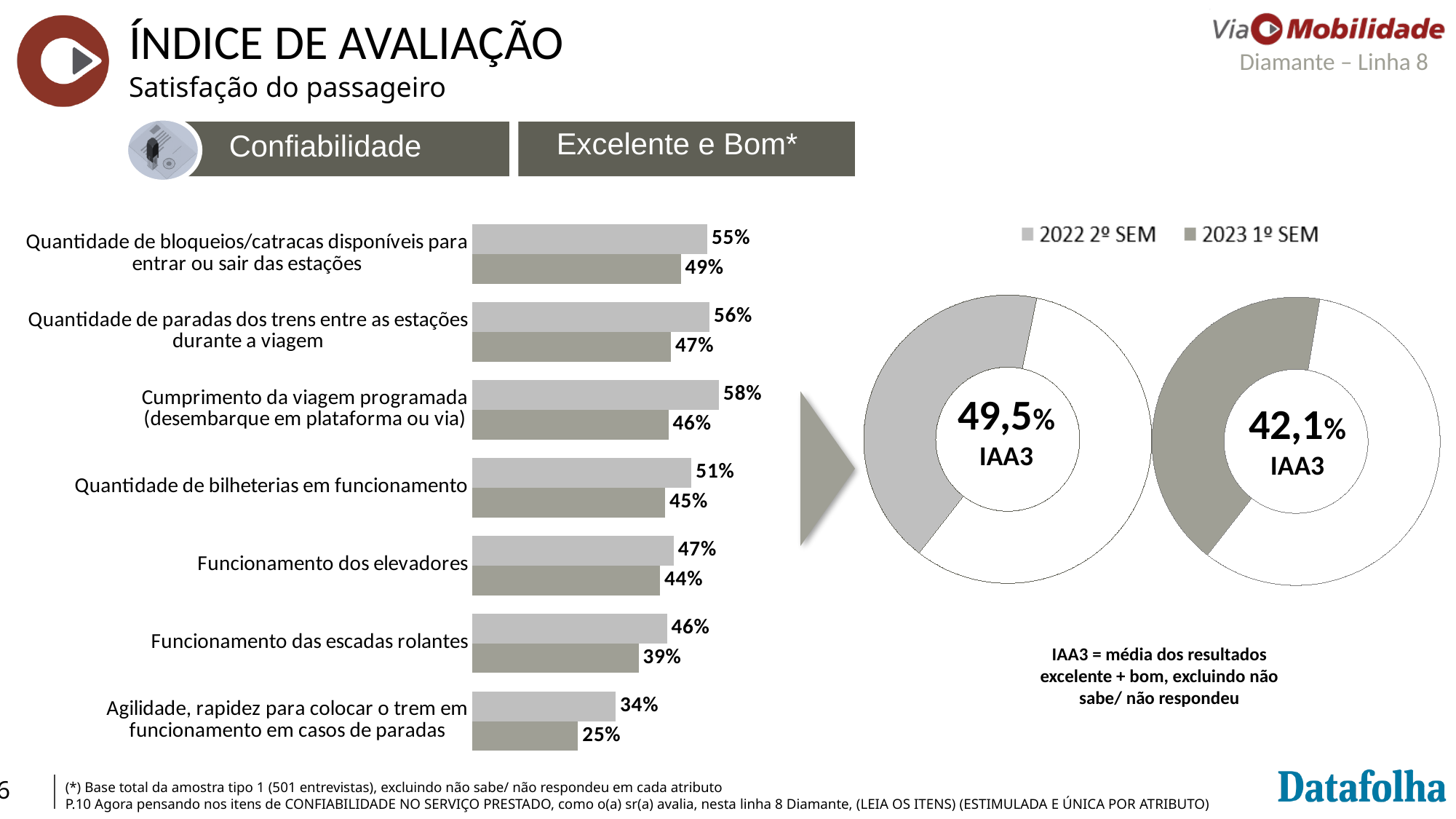
How many series does the legend list? 2 In the bar chart, what is the 2023 1º SEM value for 'Agilidade, rapidez para colocar o trem em funcionamento em casos de paradas'? 25% In the bar chart, what is the 2023 1º SEM value for 'Funcionamento dos elevadores'? 44% What kind of chart is used on the left side of the slide? Bar chart In the right donut chart, what IAA3 value is shown for 2023 1º SEM? 42,1% In the bar chart, which category has the lowest 2023 1º SEM value? Agilidade, rapidez para colocar o trem em funcionamento em casos de paradas In the bar chart, what is the 2022 2º SEM value for 'Cumprimento da viagem programada (desembarque em plataforma ou via)'? 58% How many categories does the bar chart show? 7 In the bar chart, what is the difference between the 2022 2º SEM and 2023 1º SEM values for 'Cumprimento da viagem programada (desembarque em plataforma ou via)'? 12% In the bar chart, which is larger for 'Quantidade de bilheterias em funcionamento': the 2022 2º SEM value or the 2023 1º SEM value? 2022 2º SEM In the left donut chart, what IAA3 value is shown for 2022 2º SEM? 49,5% In the bar chart, which category has the highest 2022 2º SEM value? Cumprimento da viagem programada (desembarque em plataforma ou via)